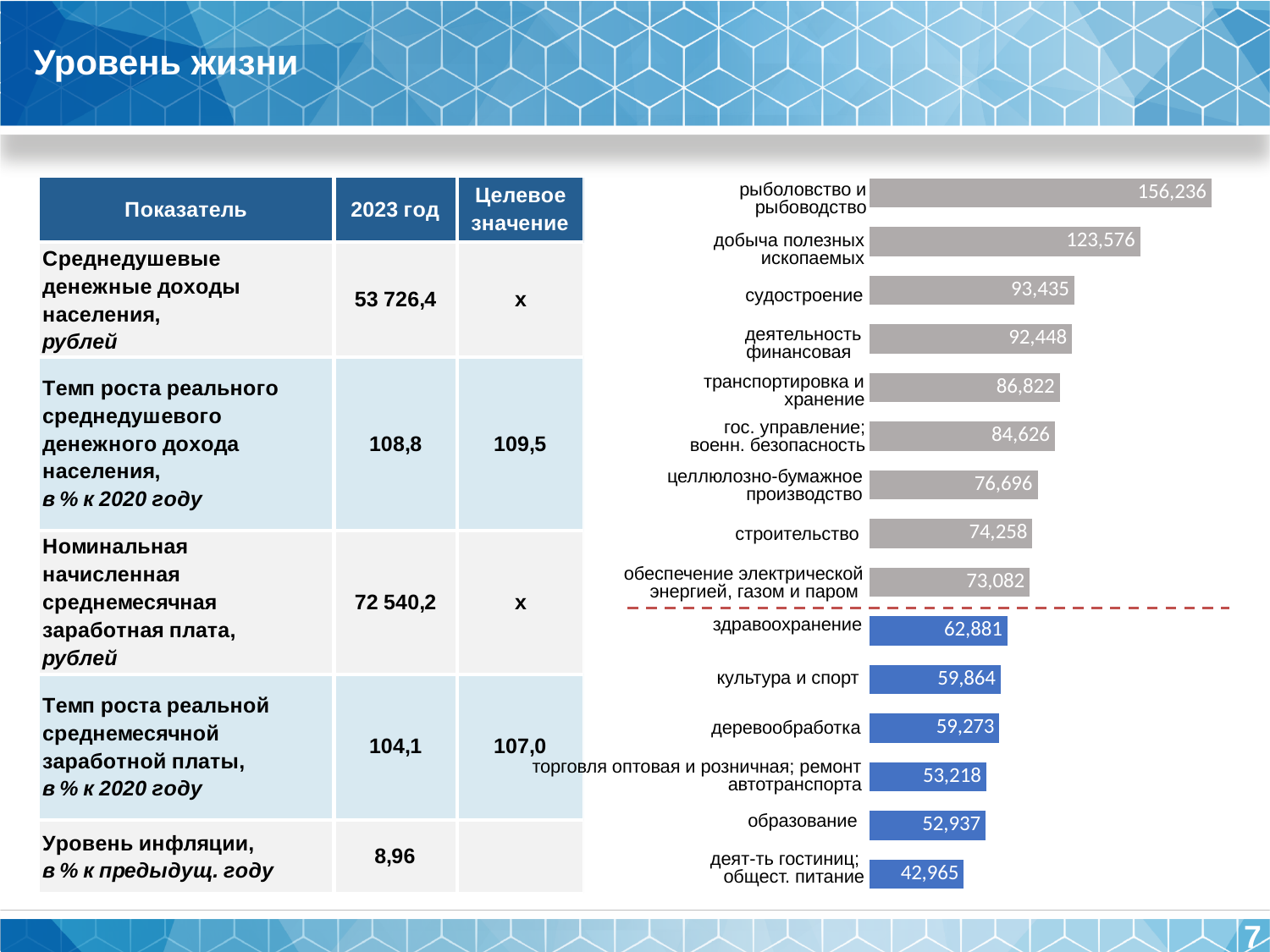
What is the value shown for строительство in the bar chart? 74,258 Which has a larger value: транспортировка и хранение or образование? транспортировка и хранение What is the difference between the values for здравоохранение and деят-ть гостиниц; общест. питание? 19,916 Which has a larger value: культура и спорт or целлюлозно-бумажное производство? целлюлозно-бумажное производство What kind of chart is shown on the right of the slide? bar chart What colour are the bars for the categories below the dashed line in the chart? blue What is the value shown for судостроение in the bar chart? 93,435 Which category has the highest value in the bar chart? рыболовство и рыбоводство Which category has the lowest value in the bar chart? деят-ть гостиниц; общест. питание How many categories are shown in the bar chart? 15 What is the value shown for здравоохранение in the bar chart? 62,881 What is the difference between the values for рыболовство и рыбоводство and добыча полезных ископаемых? 32,660